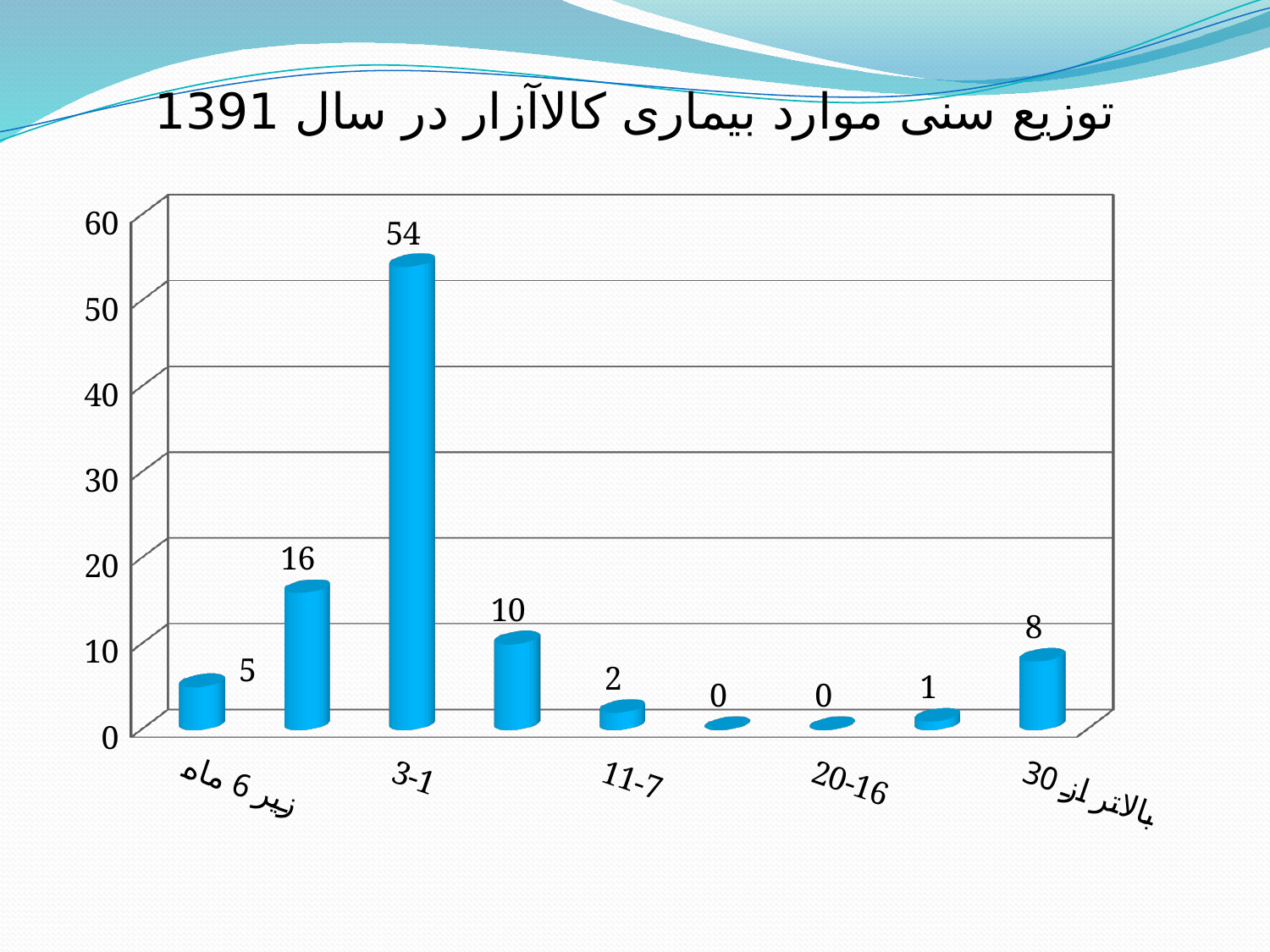
What kind of chart is shown on the slide? bar chart Which age group has the highest value? 3-1 Which is larger, the value for زیر 6 ماه or the value for بالاتر از 30? بالاتر از 30 What is the title of the chart? توزیع سنی موارد بیماری کالاآزار در سال 1391 What is the value for the زیر 6 ماه category? 5 What is the difference between the value for 3-1 and the value for بالاتر از 30? 46 What is the value for the 11-7 age group? 2 What is the value for the 20-16 age group? 0 What is the value for the 3-1 age group? 54 What is the value for the بالاتر از 30 category? 8 How many bars are plotted in the chart? 9 Is the value for 3-1 greater or less than 50? greater